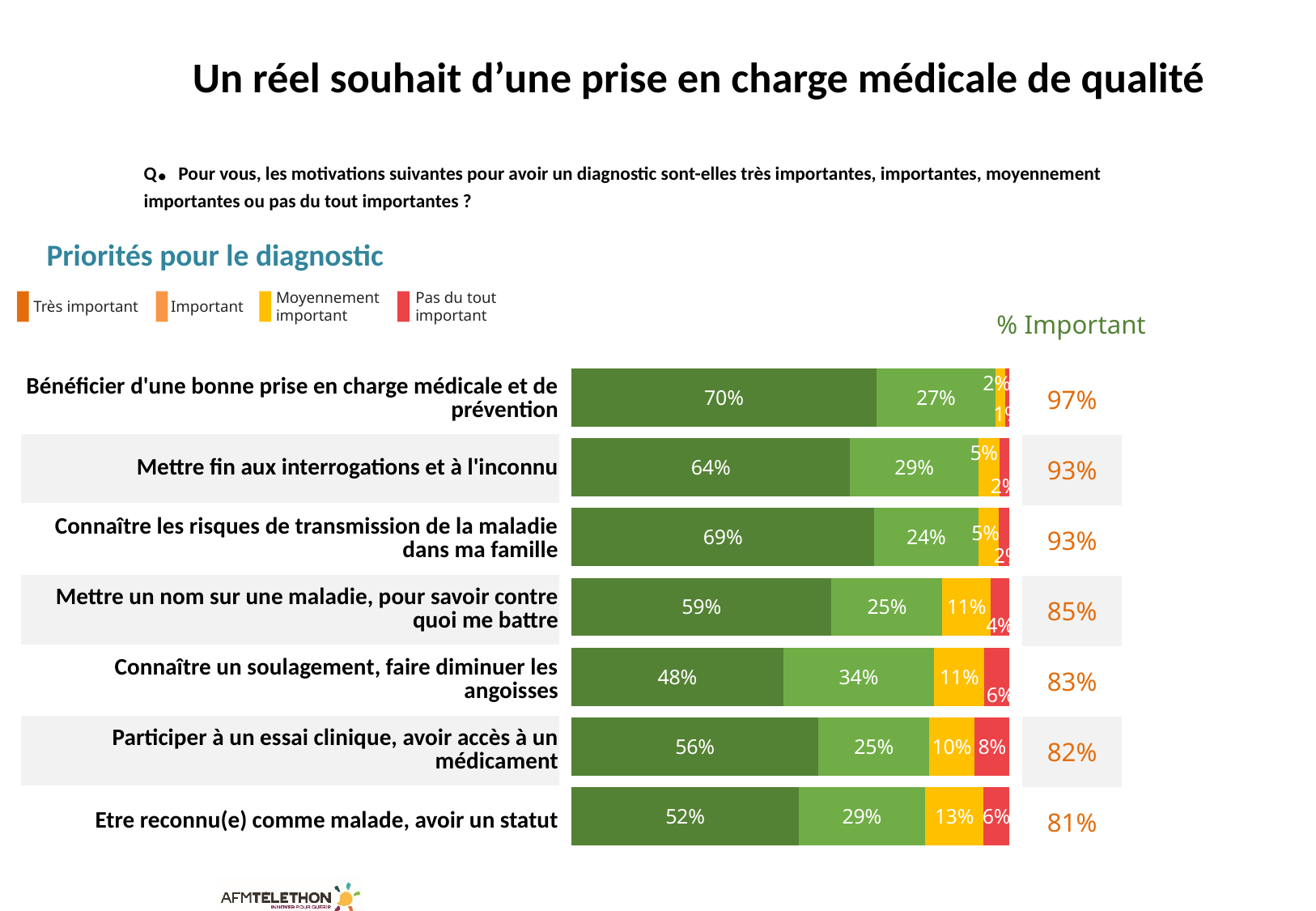
What percentage of respondents rated "Bénéficier d'une bonne prise en charge médicale et de prévention" as Très important? 70% What percentage of respondents rated "Etre reconnu(e) comme malade, avoir un statut" as Moyennement important? 13% Which has a larger Important percentage: "Connaître un soulagement, faire diminuer les angoisses" or "Connaître les risques de transmission de la maladie dans ma famille"? Connaître un soulagement, faire diminuer les angoisses What is the Pas du tout important percentage for "Participer à un essai clinique, avoir accès à un médicament"? 8% How many series does the legend list? 4 How many motivations (categories) are shown in the chart? 7 Which motivation has the lowest Très important percentage? Connaître un soulagement, faire diminuer les angoisses What is the "% Important" value shown for "Participer à un essai clinique, avoir accès à un médicament"? 82% What is the difference between the Très important percentages for "Mettre fin aux interrogations et à l'inconnu" and "Etre reconnu(e) comme malade, avoir un statut"? 12 percentage points What is the title of the chart? Priorités pour le diagnostic Which motivation has the highest "% Important" value? Bénéficier d'une bonne prise en charge médicale et de prévention What kind of chart is used to show the priorities for diagnosis? Stacked bar chart